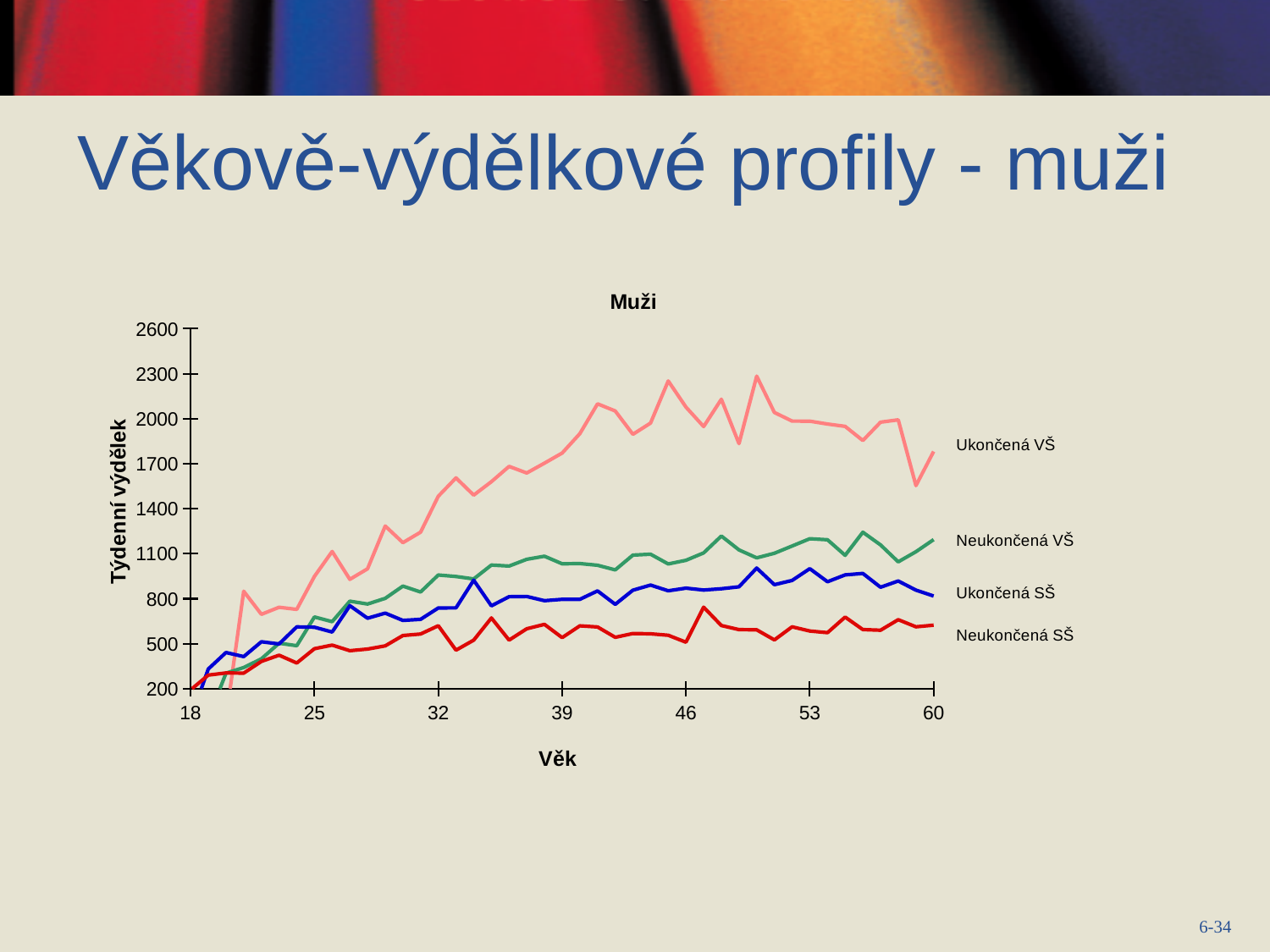
Is the value for Neukončená SŠ at age 46 greater or less than 800? less Does the Ukončená VŠ line rise or fall between age 18 and age 39? rise Which series has the highest weekly earnings across the age range? Ukončená VŠ Is the value for Ukončená VŠ at age 60 greater or less than 1400? greater How many age tick labels are shown on the x axis? 7 What is the title of the chart? Muži At age 46, which is larger: the value for Ukončená VŠ or for Neukončená SŠ? Ukončená VŠ Which series has the lowest weekly earnings across the age range? Neukončená SŠ What kind of chart is shown on the slide? line chart How many series (education groups) are plotted on the chart? 4 What is the label of the vertical axis? Týdenní výdělek Is the value for Neukončená VŠ at age 25 greater or less than 800? less